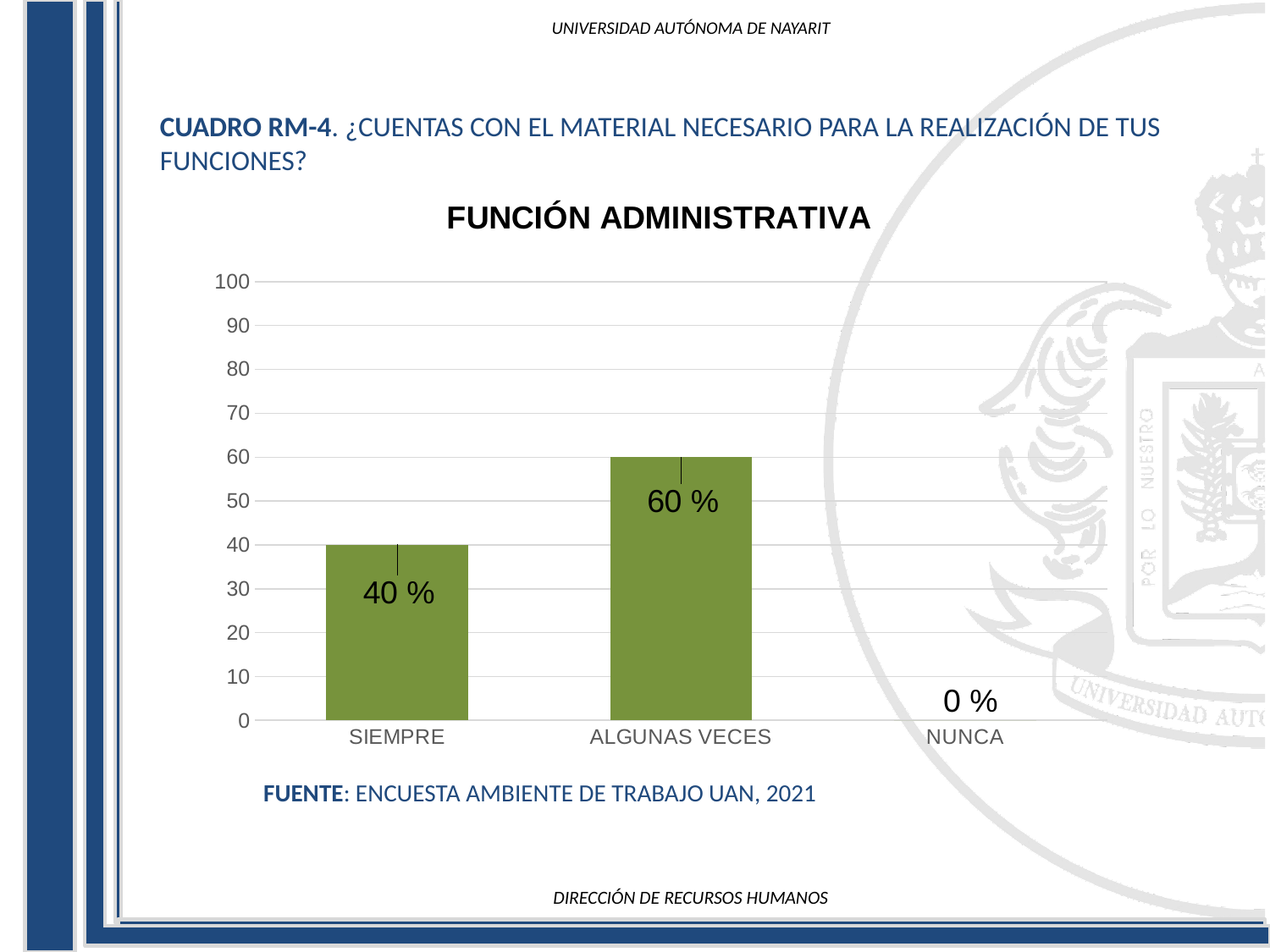
Which category has the lowest value? NUNCA Is the value for ALGUNAS VECES greater or less than 50? greater Which category has the highest value? ALGUNAS VECES What is the value for ALGUNAS VECES? 60 % What is the value for NUNCA? 0 % What kind of chart is shown on the slide? bar chart What is the maximum value shown on the y axis? 100 What is the value for SIEMPRE? 40 % What is the title of the chart? FUNCIÓN ADMINISTRATIVA Which is larger, the value for SIEMPRE or the value for ALGUNAS VECES? ALGUNAS VECES What is the difference between the values for ALGUNAS VECES and SIEMPRE? 20 % How many categories are shown on the x axis? 3